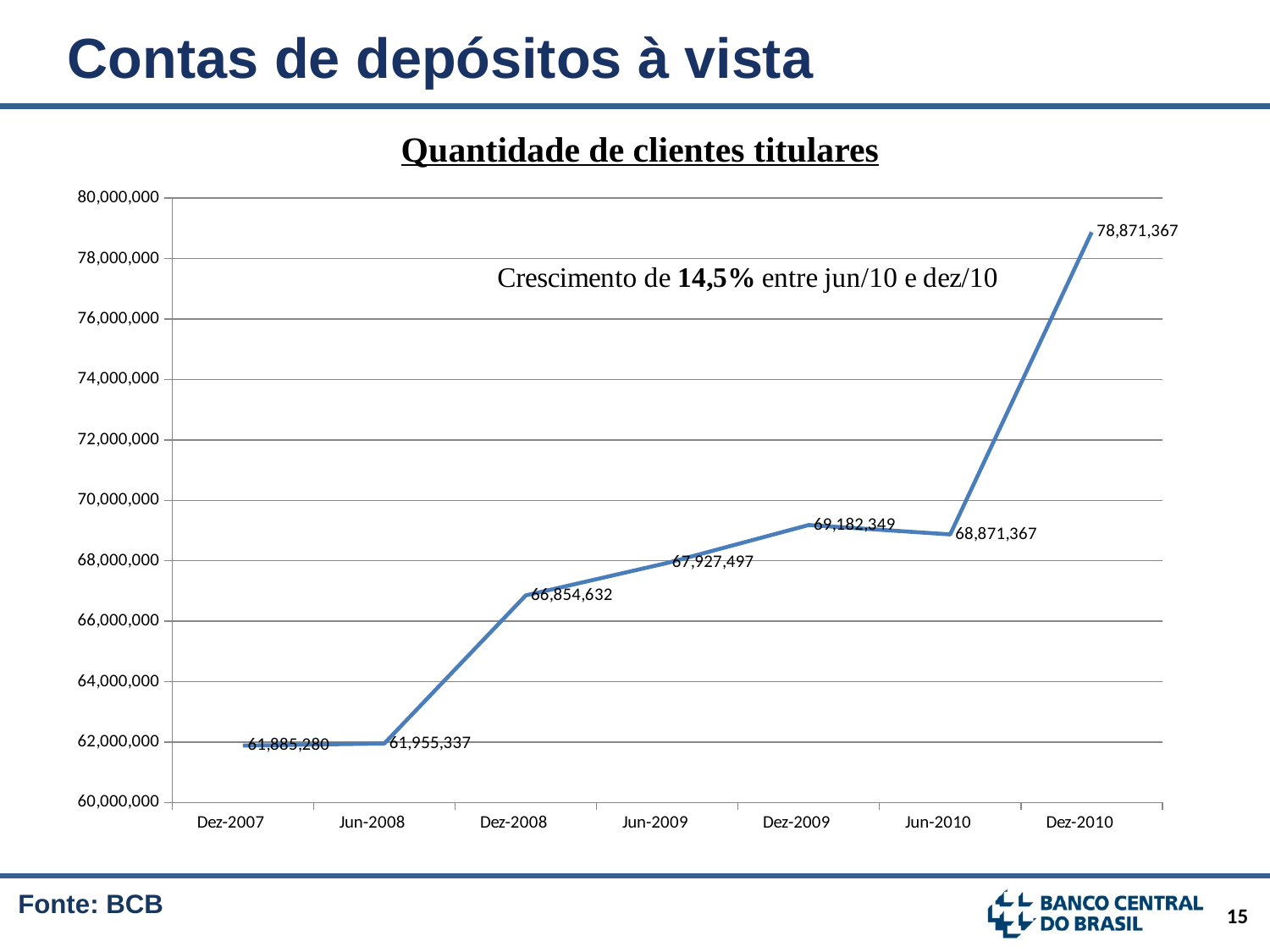
What type of chart is shown on the slide? line chart How many data points are plotted on the chart? 7 What is the value for Jun-2009? 67,927,497 Which period has the lowest number of clientes titulares? Dez-2007 Which period has the highest number of clientes titulares? Dez-2010 What is the difference between the values for Dez-2010 and Jun-2010? 10,000,000 What is the difference between the values for Dez-2008 and Jun-2008? 4,899,295 What is the value for Dez-2010? 78,871,367 What is the value for Dez-2007? 61,885,280 What is the title of the chart? Quantidade de clientes titulares Which is larger, the value for Dez-2009 or the value for Jun-2010? Dez-2009 What is the value for Jun-2010? 68,871,367